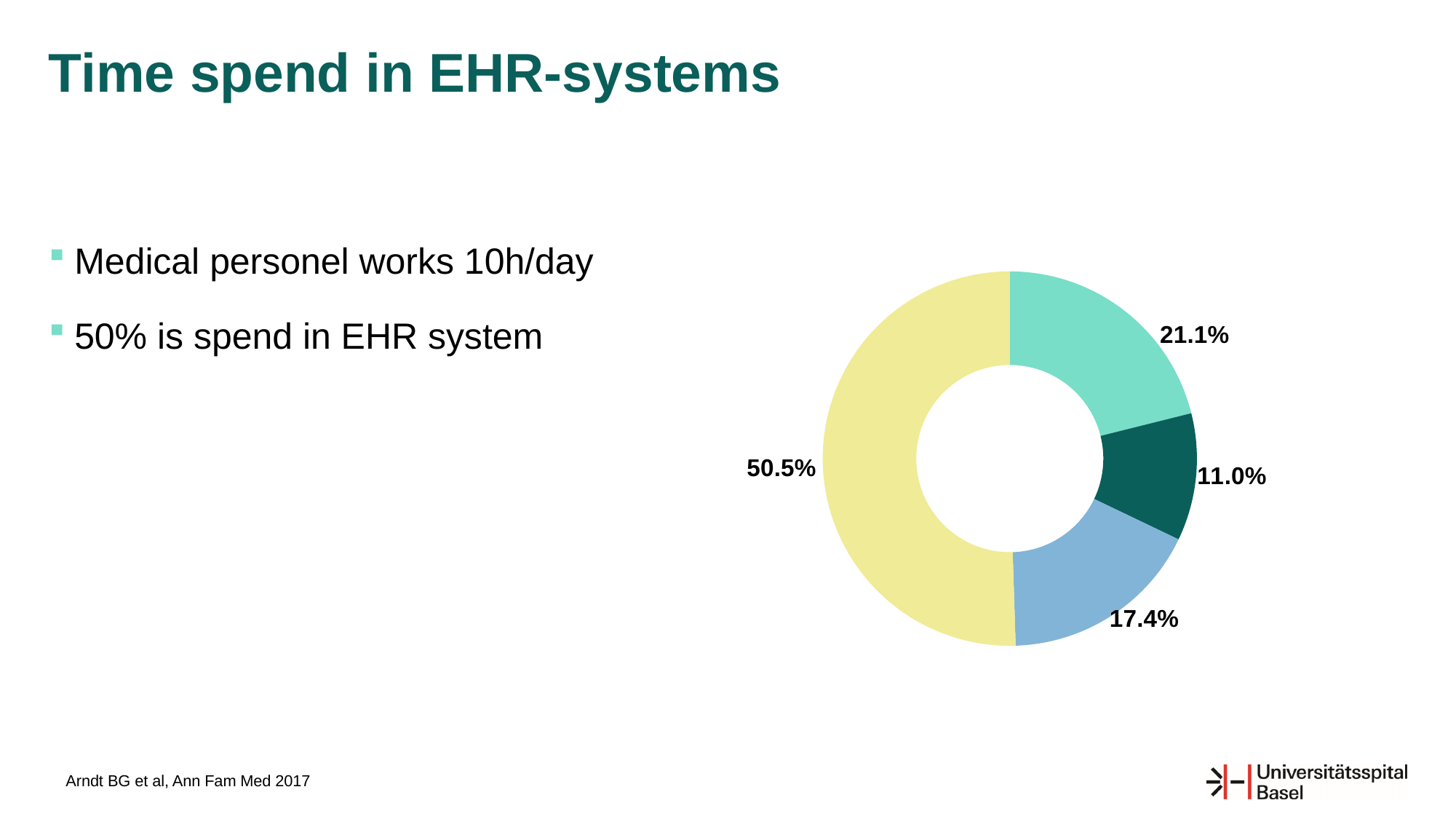
Which is larger in the doughnut chart: the light teal slice or the light blue slice? the light teal slice (21.1%) What is the combined value of the 21.1%, 11.0% and 17.4% slices in the doughnut chart? 49.5% What kind of chart is shown on the slide? doughnut chart How many slices does the doughnut chart have? 4 Which slice of the doughnut chart is the largest? the yellow slice (50.5%) What is the title of the slide containing the doughnut chart? Time spend in EHR-systems What is the value of the yellow slice in the doughnut chart? 50.5% What is the difference between the largest slice (50.5%) and the smallest slice (11.0%) in the doughnut chart? 39.5% What is the value of the light blue slice in the doughnut chart? 17.4% What is the value of the dark green slice in the doughnut chart? 11.0% What is the value of the light teal slice at the top right of the doughnut chart? 21.1% Which slice of the doughnut chart is the smallest? the dark green slice (11.0%)